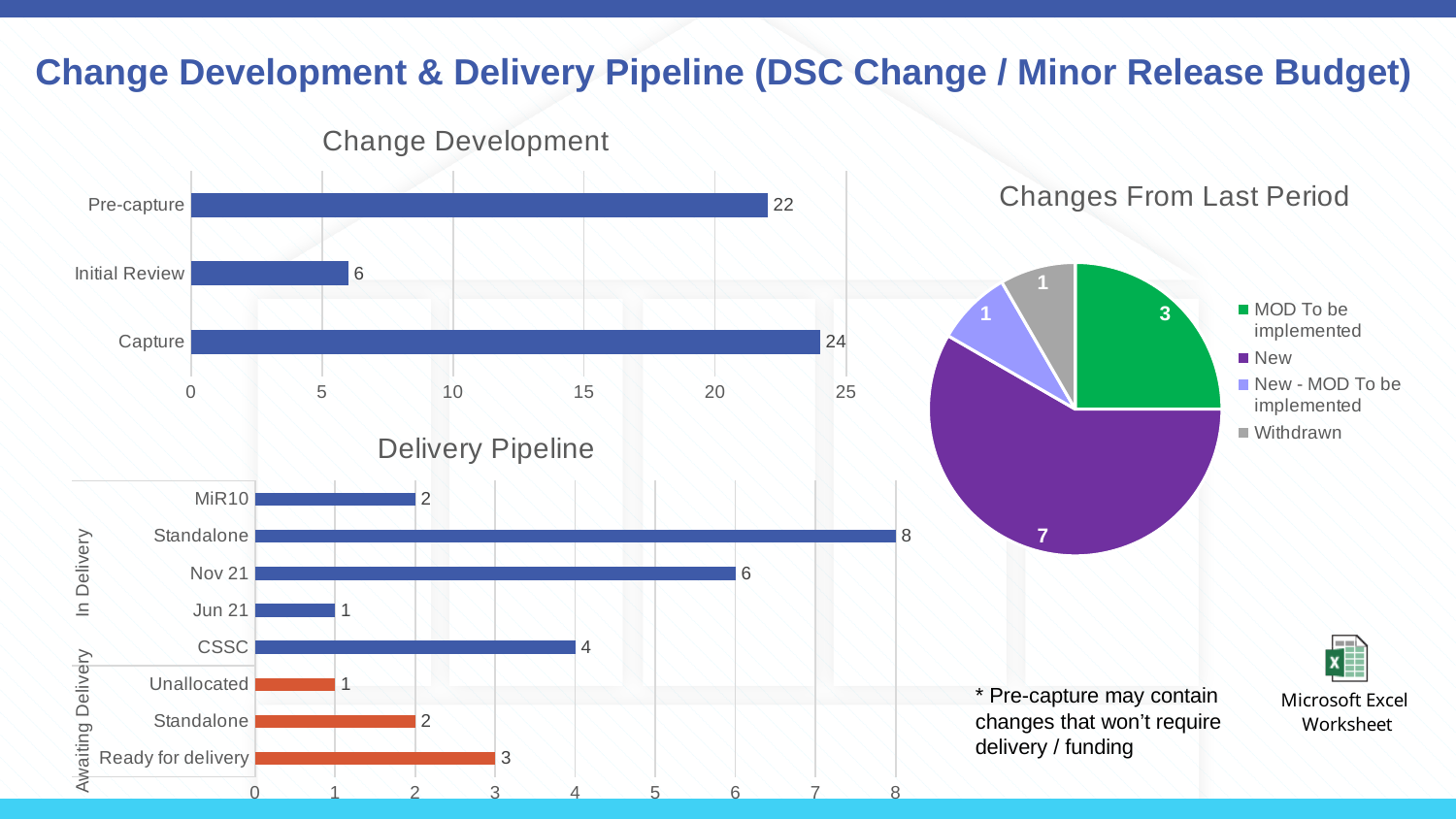
In the Change Development chart, how many categories are shown? 3 In the Delivery Pipeline chart, what is the value for Ready for delivery under Awaiting Delivery? 3 In the Change Development chart, what is the difference between Capture and Initial Review? 18 In the Delivery Pipeline chart, how many categories are shown in total? 8 In the Change Development chart, which category has the highest value? Capture In the Changes From Last Period pie chart, what is the value for New? 7 In the Delivery Pipeline chart, which category has the highest value? Standalone (In Delivery) In the Delivery Pipeline chart, what is the value for Nov 21? 6 What kind of chart is Changes From Last Period? Pie chart In the Delivery Pipeline chart, which is larger: CSSC or MiR10? CSSC In the Changes From Last Period pie chart, what share of the total does MOD To be implemented represent? 25% In the Change Development chart, what is the value for Pre-capture? 22